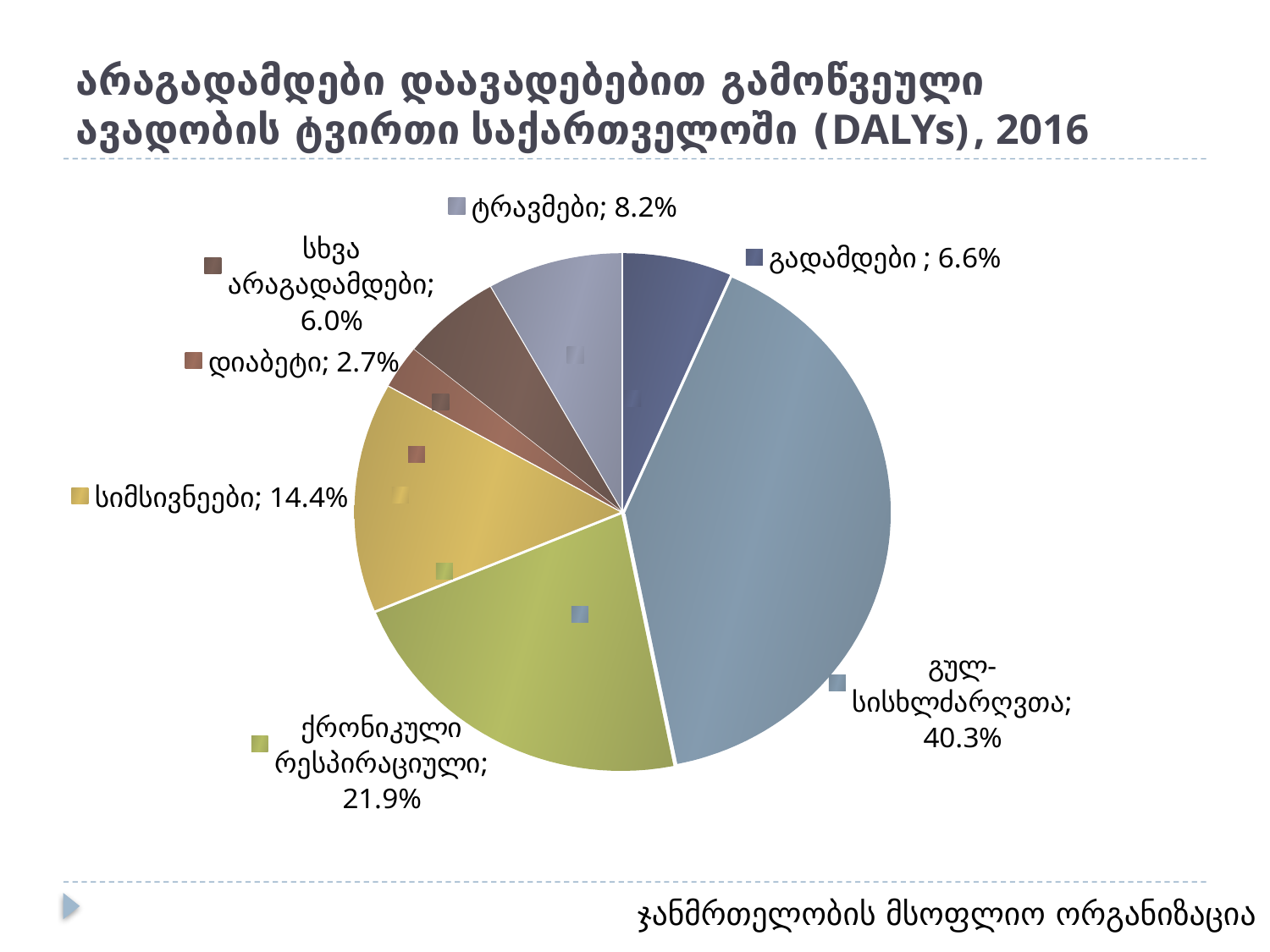
Which category has the largest slice of the pie? გულ-სისხლძარღვთა What is the value shown for ტრავმები? 8.2% How many slices does the pie chart have? 7 Which category has the smallest slice of the pie? დიაბეტი What is the difference between the values for გულ-სისხლძარღვთა and ქრონიკული რესპირაციული? 18.4% What kind of chart is shown on the slide? pie chart What is the value shown for დიაბეტი? 2.7% What share of the pie does გულ-სისხლძარღვთა have? 40.3% What is the value shown for ქრონიკული რესპირაციული? 21.9% Which is larger, the value for გადამდები or the value for სხვა არაგადამდები? გადამდები What is the value shown for სიმსივნეები? 14.4% What year is given in the chart title? 2016